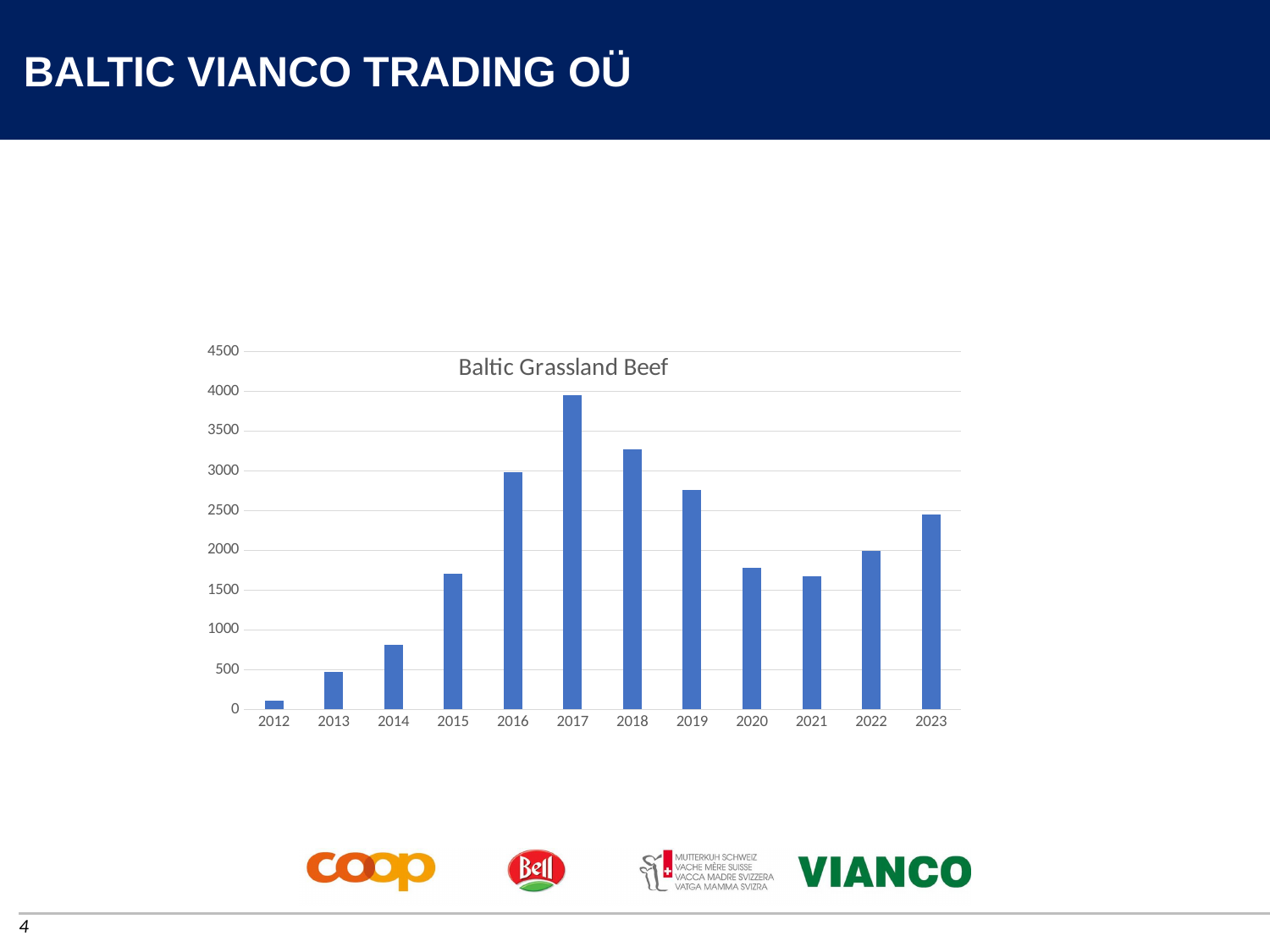
Is the value for 2012 greater or less than 500? less Which year has the highest value in the chart? 2017 Is the value for 2023 greater or less than 2000? greater Which year has the larger value, 2022 or 2023? 2023 Is the value for 2017 greater or less than 3500? greater What is the title of the chart? Baltic Grassland Beef What kind of chart is shown on the slide? bar chart How many years are shown on the x axis of the chart? 12 Which year has the lowest value in the chart? 2012 Which year has the larger value, 2018 or 2019? 2018 Do the values rise or fall from 2012 to 2017? rise